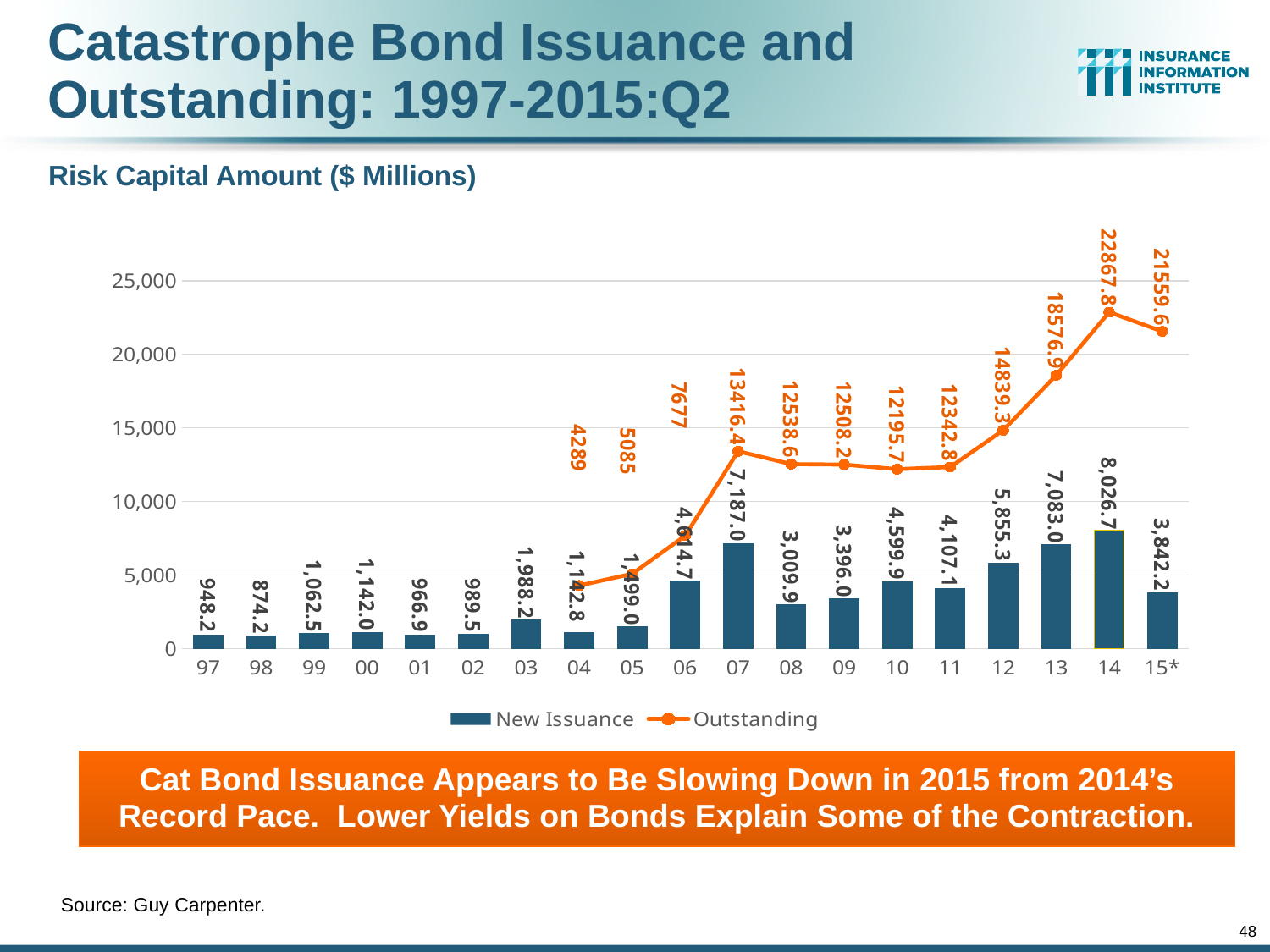
What is the Outstanding value for 14? 22867.8 What kind of chart is shown on the slide? Combined bar and line chart What is the New Issuance value for 14? 8,026.7 Which is larger, the New Issuance value for 07 or for 13? 07 What is the New Issuance value for 15*? 3,842.2 What is the difference between the New Issuance values for 14 and 15*? 4,184.5 How many series does the legend list? 2 Which year has the highest New Issuance value? 14 Which year has the lowest New Issuance value? 98 What is the Outstanding value for 04? 4289 Which year has the highest Outstanding value? 14 How many years are shown on the x axis? 19